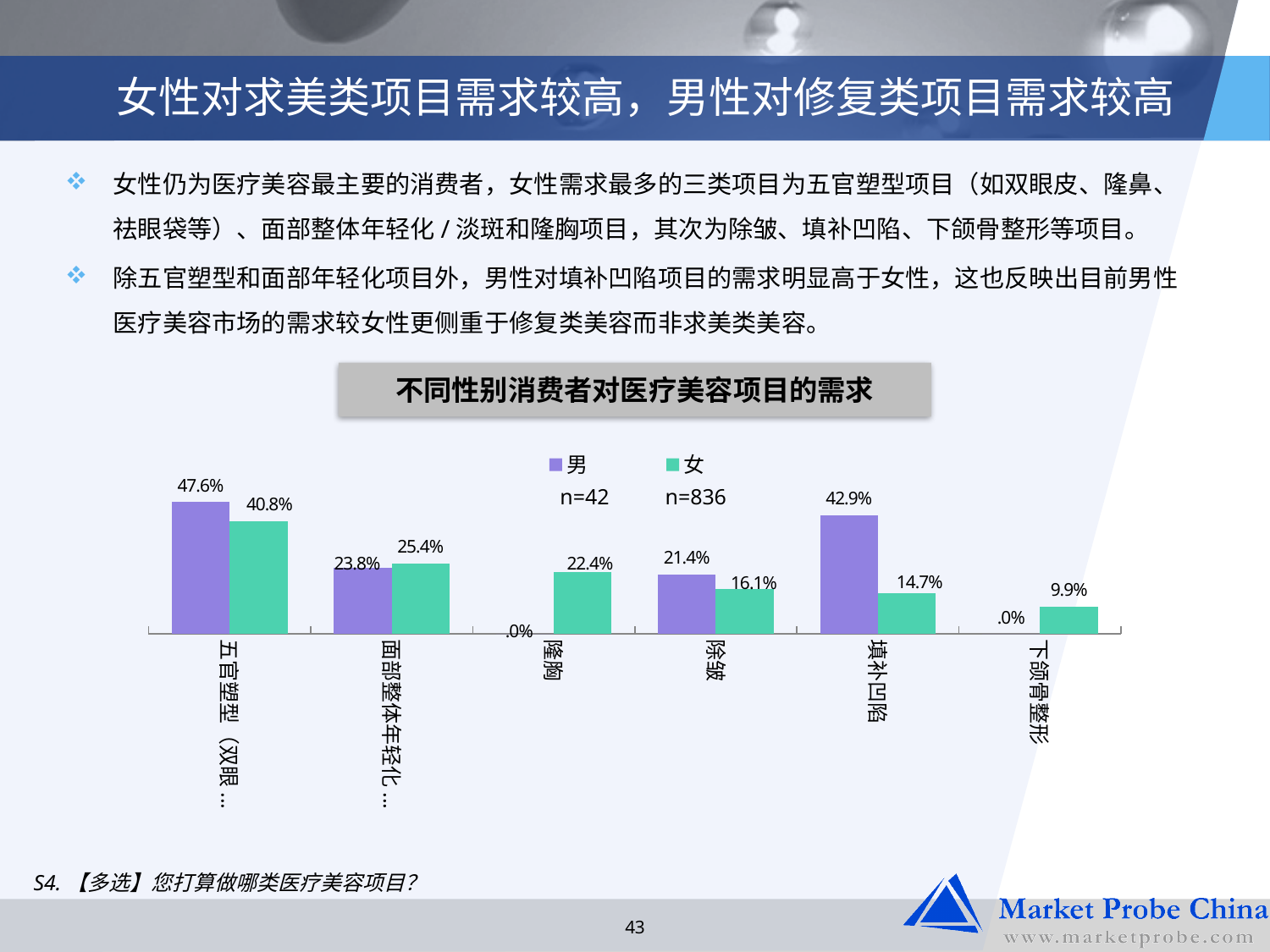
What type of chart is shown on the slide? bar chart In the 面部整体年轻化… category, which series has the larger value, 男 or 女? 女 What is the value for 女 in the 下颌骨整形 category? 9.9% How many series does the legend list in the chart? 2 What is the value for 女 in the 隆胸 category? 22.4% What is the difference between the 男 and 女 values in the 填补凹陷 category? 28.2% Which category has the lowest value for the 女 series? 下颌骨整形 What sample size (n) is shown for the 女 series in the legend? n=836 In the 除皱 category, which series has the larger value, 男 or 女? 男 How many categories are shown on the x axis of the chart? 6 Which category has the highest value for the 男 series? 五官塑型（双眼…） What is the value for 男 in the 填补凹陷 category? 42.9%